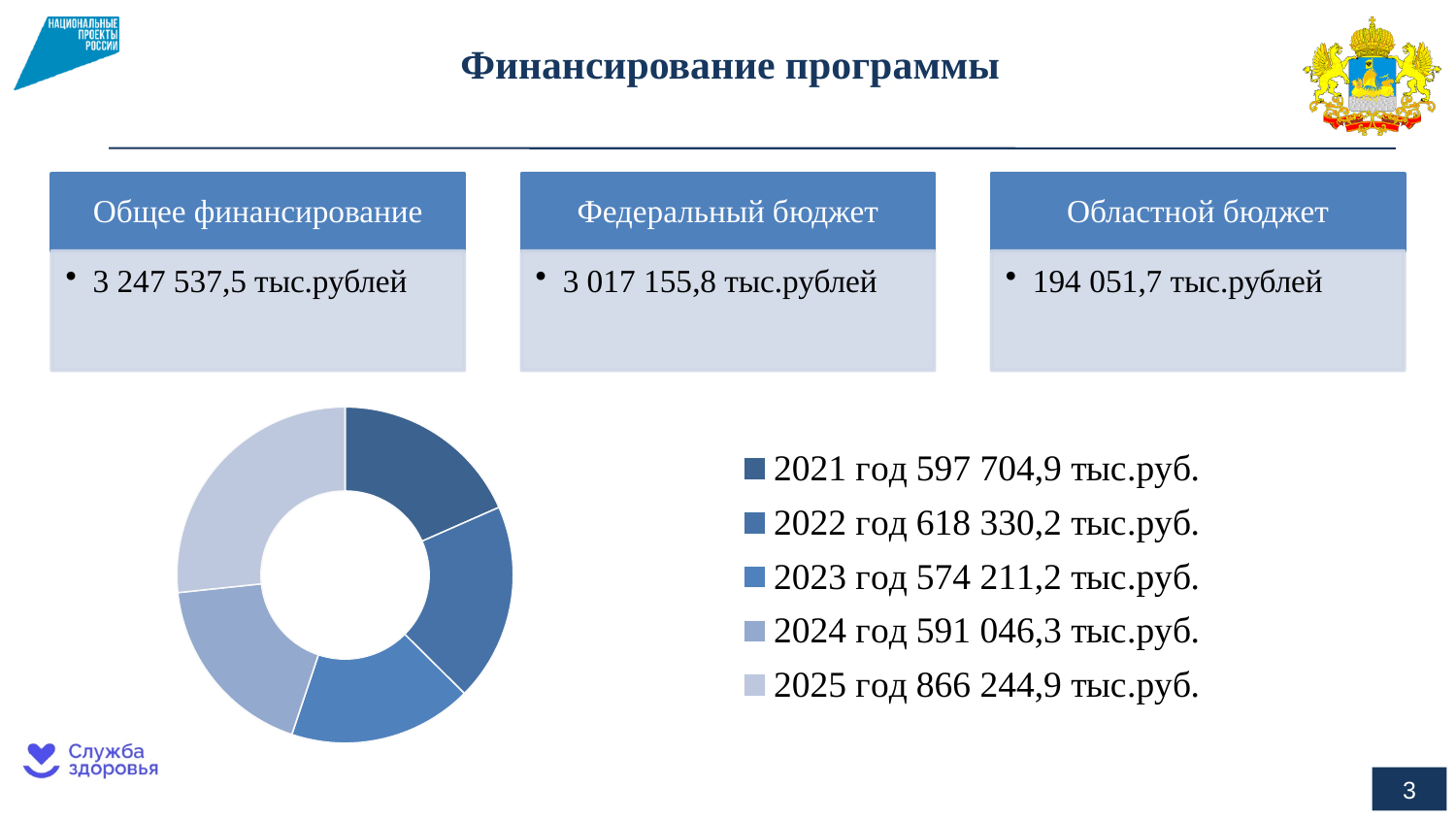
What is the total of all five values in the doughnut chart? 3 247 537,5 тыс.руб. Which year has the smallest value in the doughnut chart? 2023 год What is the difference between the values for 2025 год and 2021 год? 268 540,0 тыс.руб. What is the value for 2023 год in the doughnut chart? 574 211,2 тыс.руб. What type of chart is shown on the slide? Doughnut chart What is the difference between the values for 2022 год and 2023 год? 44 119,0 тыс.руб. What is the value for 2025 год in the doughnut chart? 866 244,9 тыс.руб. Which is larger, the value for 2022 год or the value for 2024 год? 2022 год How many slices does the doughnut chart have? 5 How many entries does the legend of the doughnut chart list? 5 What is the value for 2021 год in the doughnut chart? 597 704,9 тыс.руб. Which year has the largest value in the doughnut chart? 2025 год